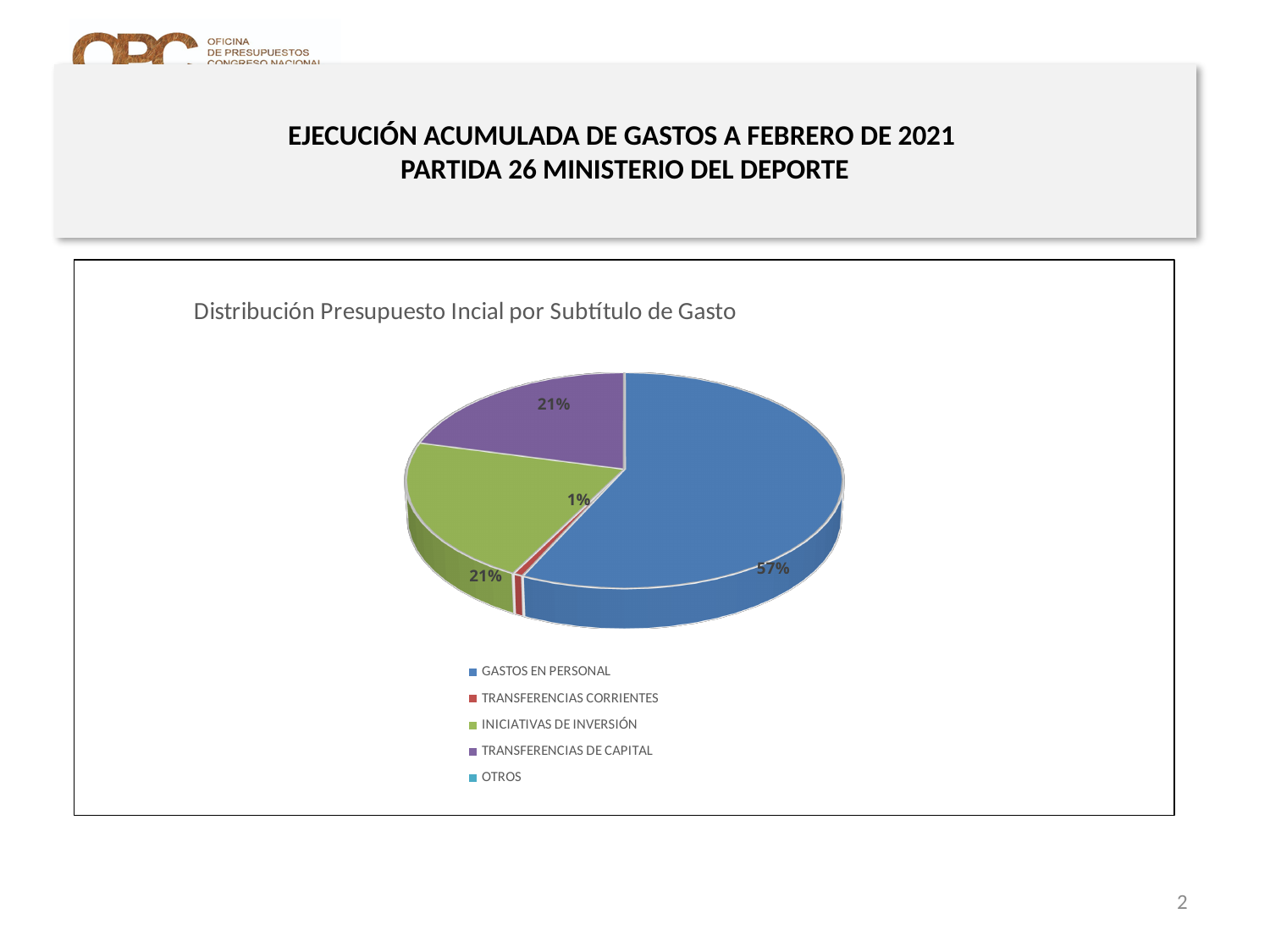
What colour is the slice for GASTOS EN PERSONAL? blue Which of the labeled slices is the smallest? TRANSFERENCIAS CORRIENTES Which category has the largest slice of the pie? GASTOS EN PERSONAL What share of the pie does TRANSFERENCIAS DE CAPITAL represent? 21% What share of the pie does TRANSFERENCIAS CORRIENTES represent? 1% What is the title of the chart? Distribución Presupuesto Incial por Subtítulo de Gasto What kind of chart is shown on the slide? pie chart Which is larger, the share for GASTOS EN PERSONAL or the share for INICIATIVAS DE INVERSIÓN? GASTOS EN PERSONAL What share of the pie does GASTOS EN PERSONAL represent? 57% How many entries does the legend list? 5 What share of the pie does INICIATIVAS DE INVERSIÓN represent? 21% By how many percentage points does the GASTOS EN PERSONAL share exceed the TRANSFERENCIAS DE CAPITAL share? 36 percentage points